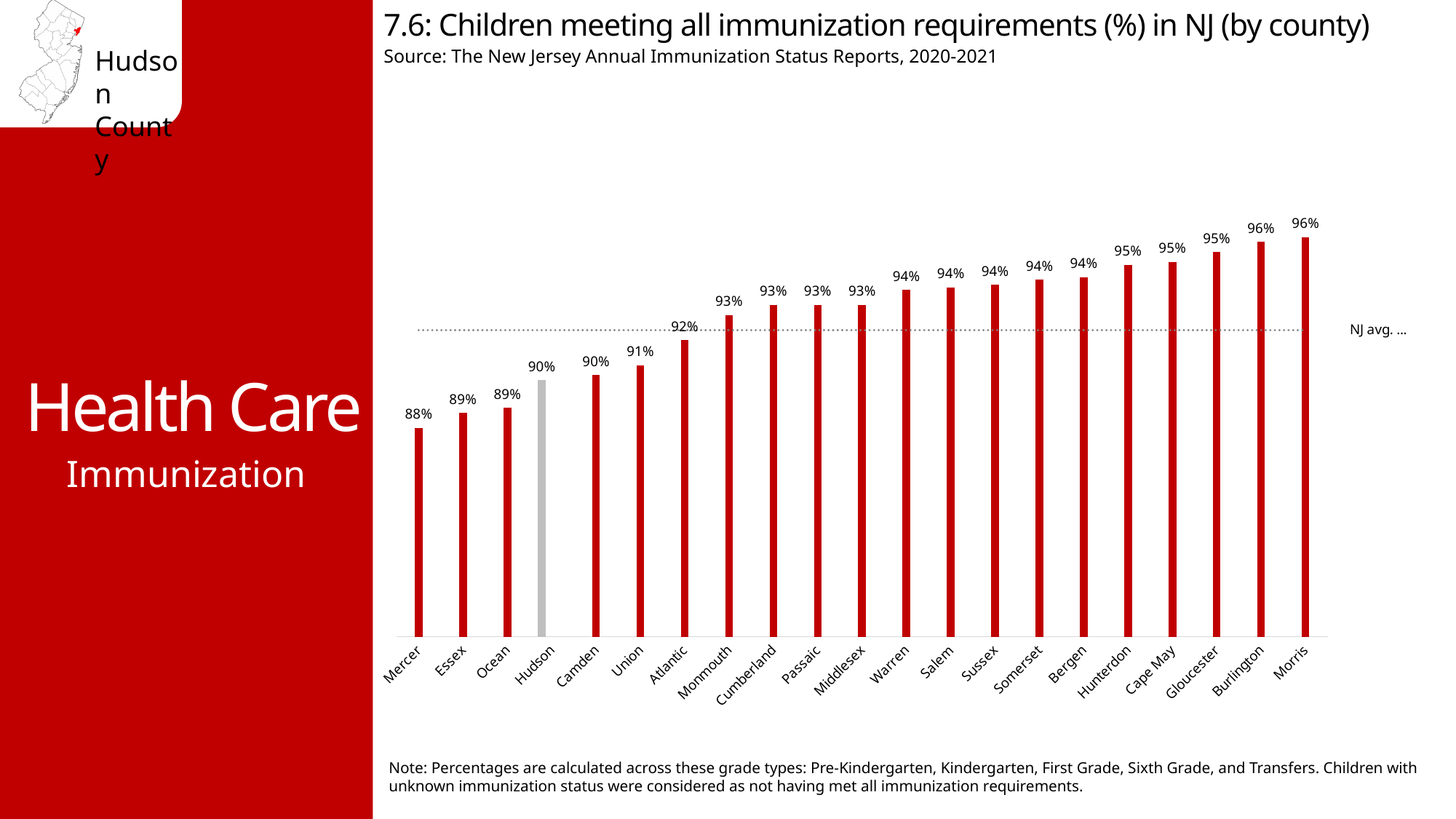
What is the difference in percentage points between Hudson County and Mercer County? 2 percentage points Which county's bar is coloured grey instead of red? Hudson Which has a higher value, Union County or Monmouth County? Monmouth What is the value shown for Mercer County? 88% Which county has the lowest percentage of children meeting all immunization requirements? Mercer What percentage of children in Hudson County met all immunization requirements? 90% What kind of chart is used on this slide? Bar chart How many counties are shown in the chart? 21 Do the values rise or fall moving from left to right along the x axis? Rise What is the value shown for Bergen County? 94% What percentage is shown for Atlantic County? 92% What is the difference in percentage points between Morris County and Mercer County? 8 percentage points